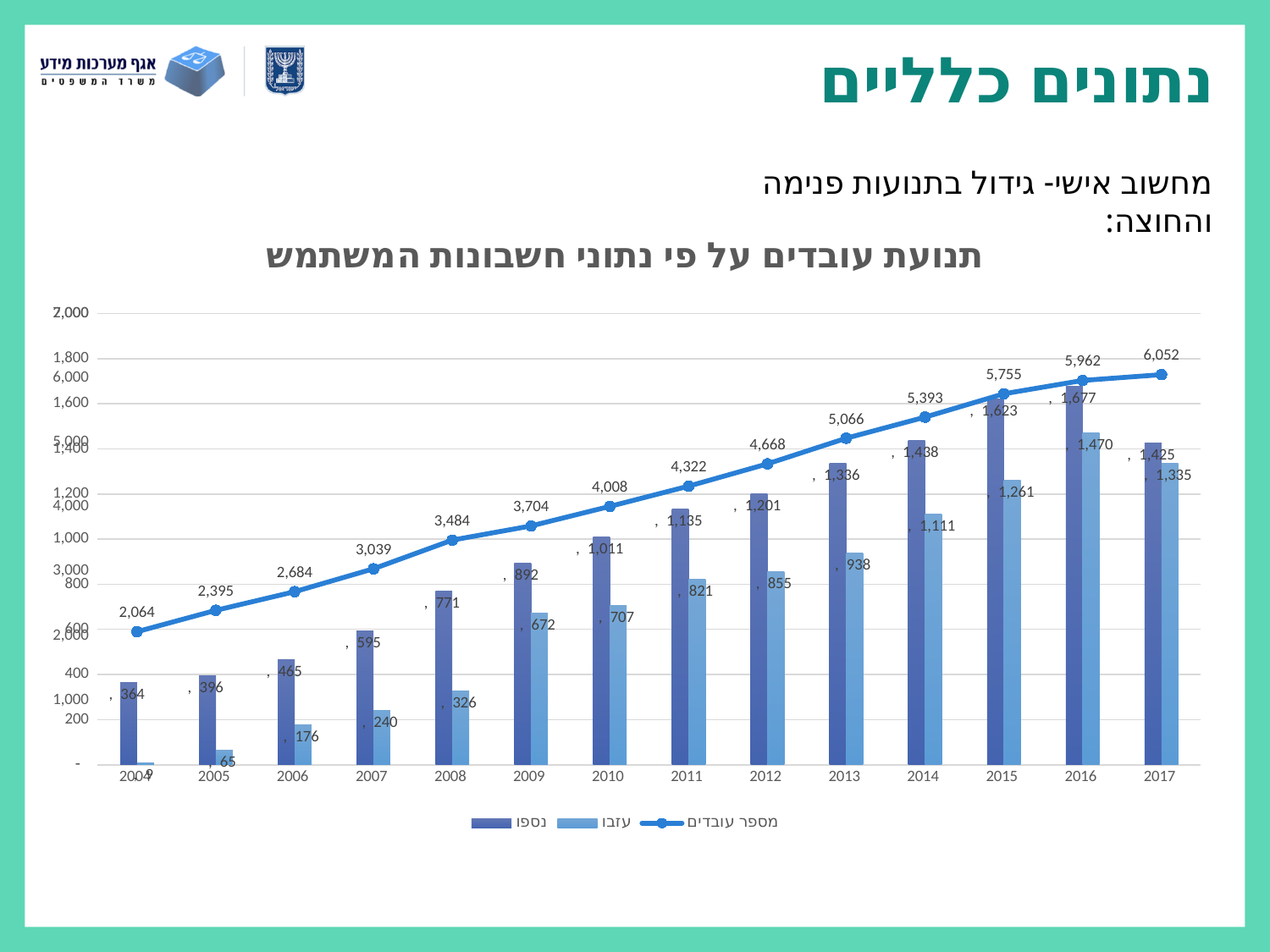
How many series does the legend list? 3 Does the מספר עובדים line rise or fall from 2004 to 2017? Rises What is the title of the chart? תנועת עובדים על פי נתוני חשבונות המשתמש Which is larger in 2012, the נספו value or the עזבו value? נספו What is the value of the מספר עובדים line for 2017? 6,052 In which year is the עזבו bar lowest? 2004 In which year is the נספו bar highest? 2016 What is the difference between the נספו and עזבו values in 2016? 207 What is the value of the נספו bar for 2010? 1,011 How many years are shown on the x axis? 14 What is the value of the עזבו bar for 2013? 938 What kind of chart is this? Combined bar and line chart